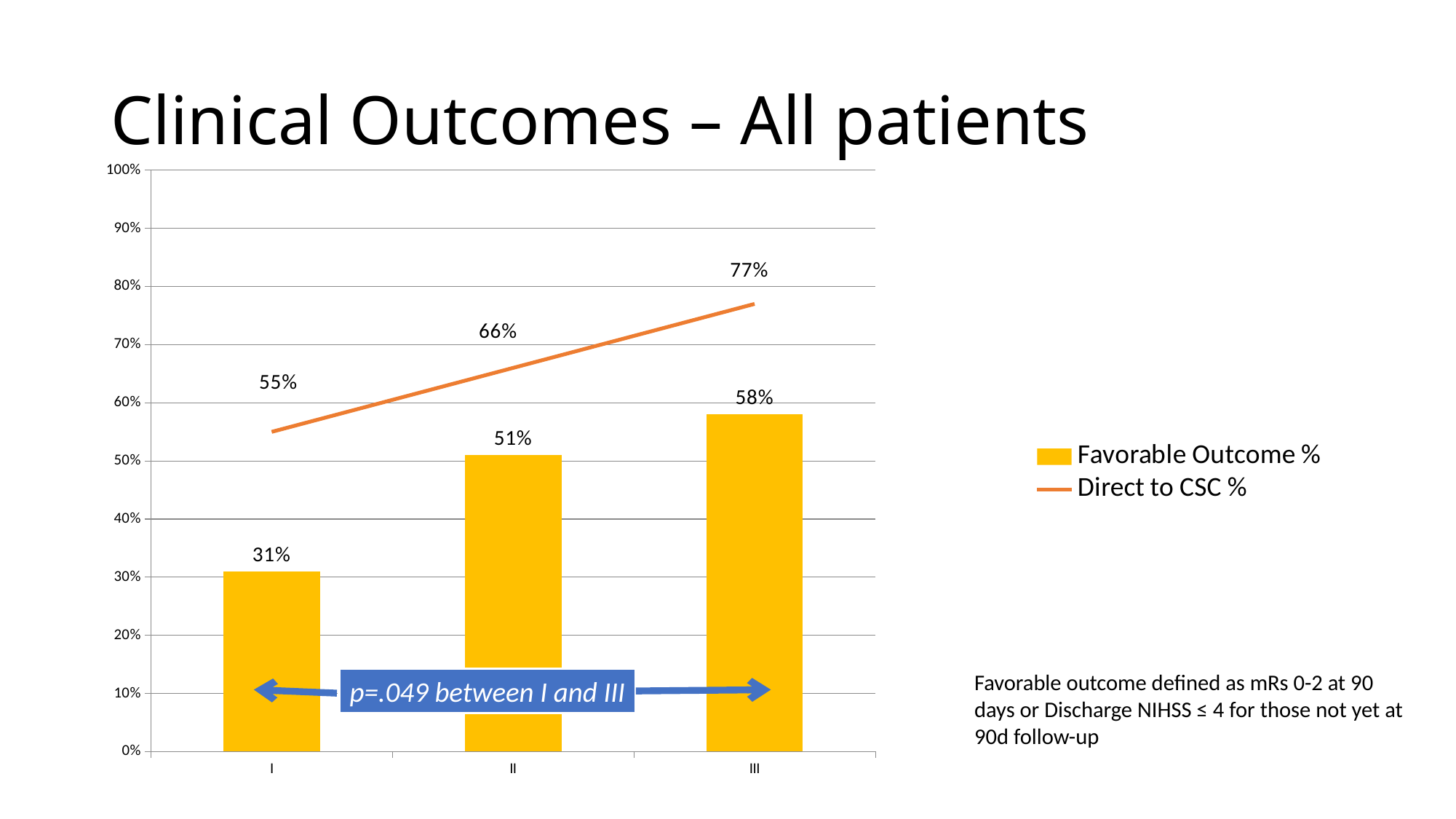
What is the difference in Favorable Outcome % between category III and category I? 27% Which category has the highest Favorable Outcome %? III How many series does the legend list? 2 What is the Favorable Outcome % for category I? 31% Does the Direct to CSC % rise or fall from category I to category III? rise What is the Direct to CSC % for category III? 77% How many categories are shown on the x axis? 3 What is the title of the slide containing the chart? Clinical Outcomes – All patients Which is larger for category II: Favorable Outcome % or Direct to CSC %? Direct to CSC % What is the Direct to CSC % for category I? 55% What is the Favorable Outcome % for category II? 51% Which category has the lowest Direct to CSC %? I